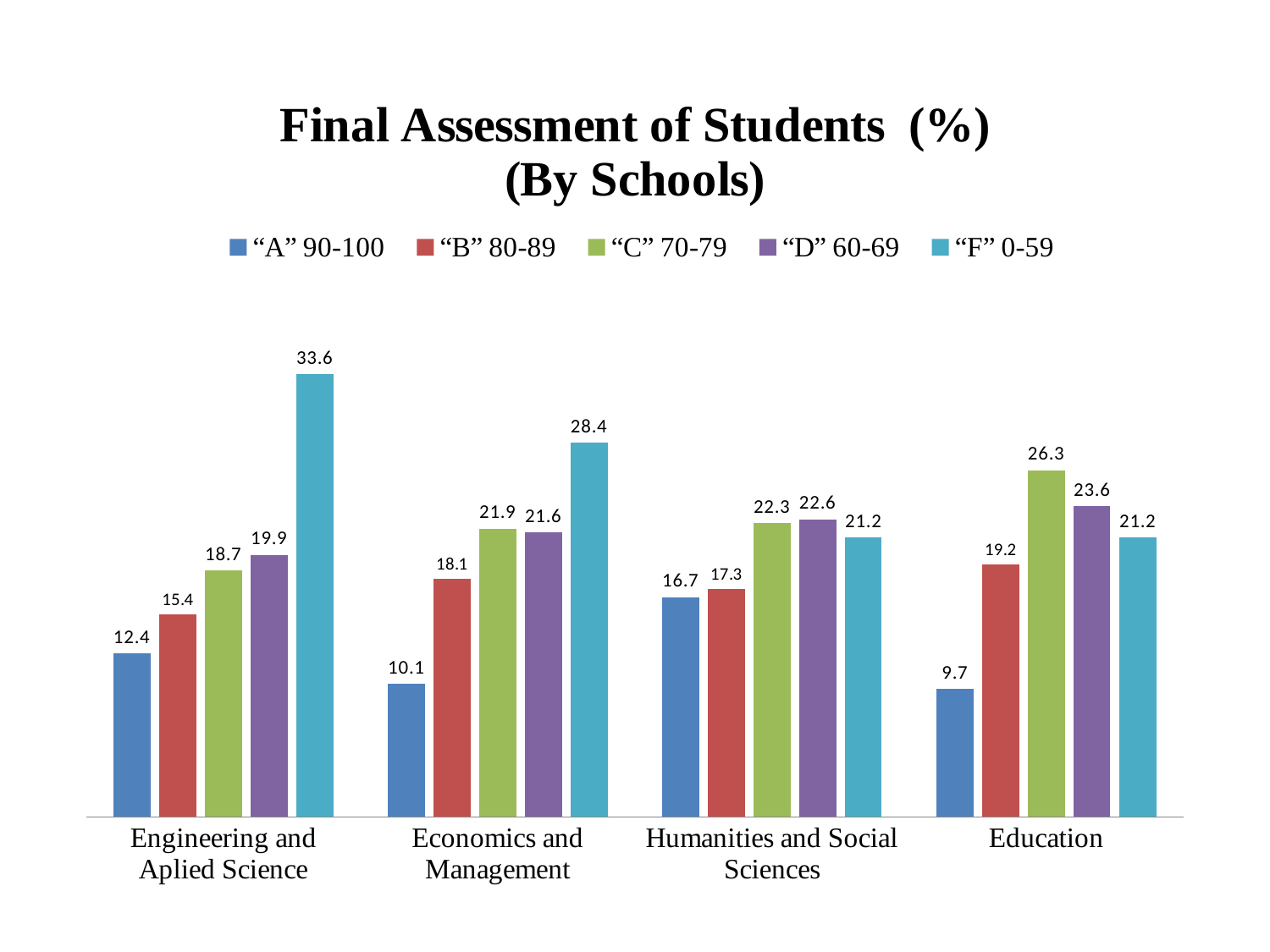
How many schools are shown on the x axis? 4 What kind of chart is shown on the slide? Bar chart What is the title of the chart? Final Assessment of Students (%) (By Schools) What is the difference between the "F" 0-59 values for Engineering and Aplied Science and Economics and Management? 5.2 Which school has the highest value for "F" 0-59? Engineering and Aplied Science What is the value for "F" 0-59 in Engineering and Aplied Science? 33.6 Which school has the lowest value for "A" 90-100? Education What is the value for "C" 70-79 in Economics and Management? 21.9 Which is larger in Education: the "C" 70-79 value or the "D" 60-69 value? "C" 70-79 What is the value for "D" 60-69 in Humanities and Social Sciences? 22.6 How many series does the legend list? 5 What is the value for "A" 90-100 in Education? 9.7